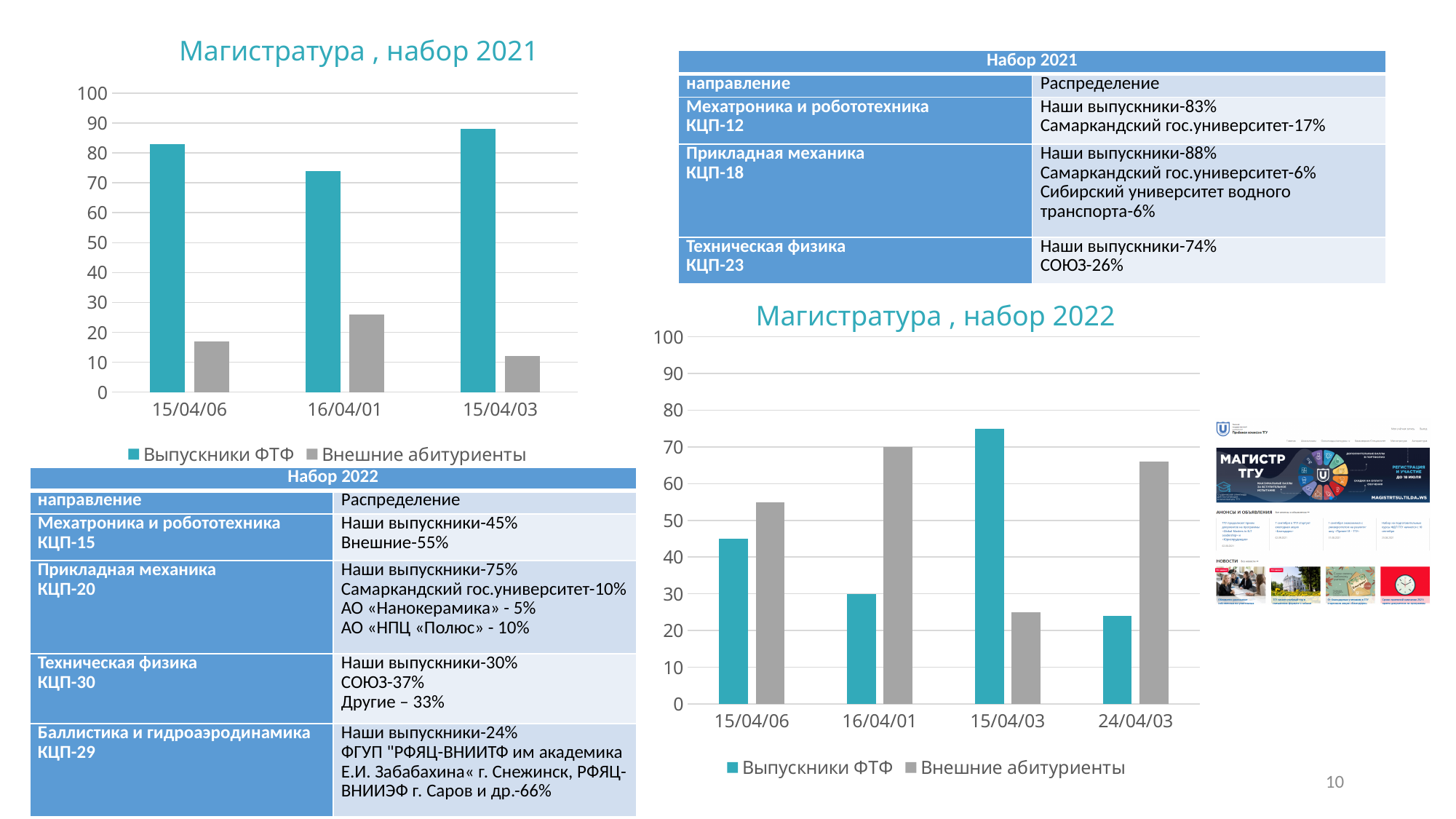
How many series does the legend of the "Магистратура , набор 2022" chart list? 2 In the "Магистратура , набор 2022" chart, at 15/04/06, which series has the larger value: Выпускники ФТФ or Внешние абитуриенты? Внешние абитуриенты How many categories are shown on the x axis of the "Магистратура , набор 2021" chart? 3 What kind of chart is the "Магистратура , набор 2021" chart? bar chart In the "Магистратура , набор 2022" chart, what is the value for Внешние абитуриенты at 16/04/01? 70 In the "Магистратура , набор 2022" chart, which category has the highest value for Выпускники ФТФ? 15/04/03 In the "Магистратура , набор 2021" chart, which category has the lowest value for Внешние абитуриенты? 15/04/03 In the "Магистратура , набор 2021" chart, which category has the highest value for Выпускники ФТФ? 15/04/03 In the "Магистратура , набор 2021" chart, is the value for Внешние абитуриенты at 16/04/01 greater or less than 30? less In the "Магистратура , набор 2022" chart, what is the value for Выпускники ФТФ at 16/04/01? 30 How many categories are shown on the x axis of the "Магистратура , набор 2022" chart? 4 In the "Магистратура , набор 2021" chart, is the value for Выпускники ФТФ at 15/04/06 greater or less than 80? greater